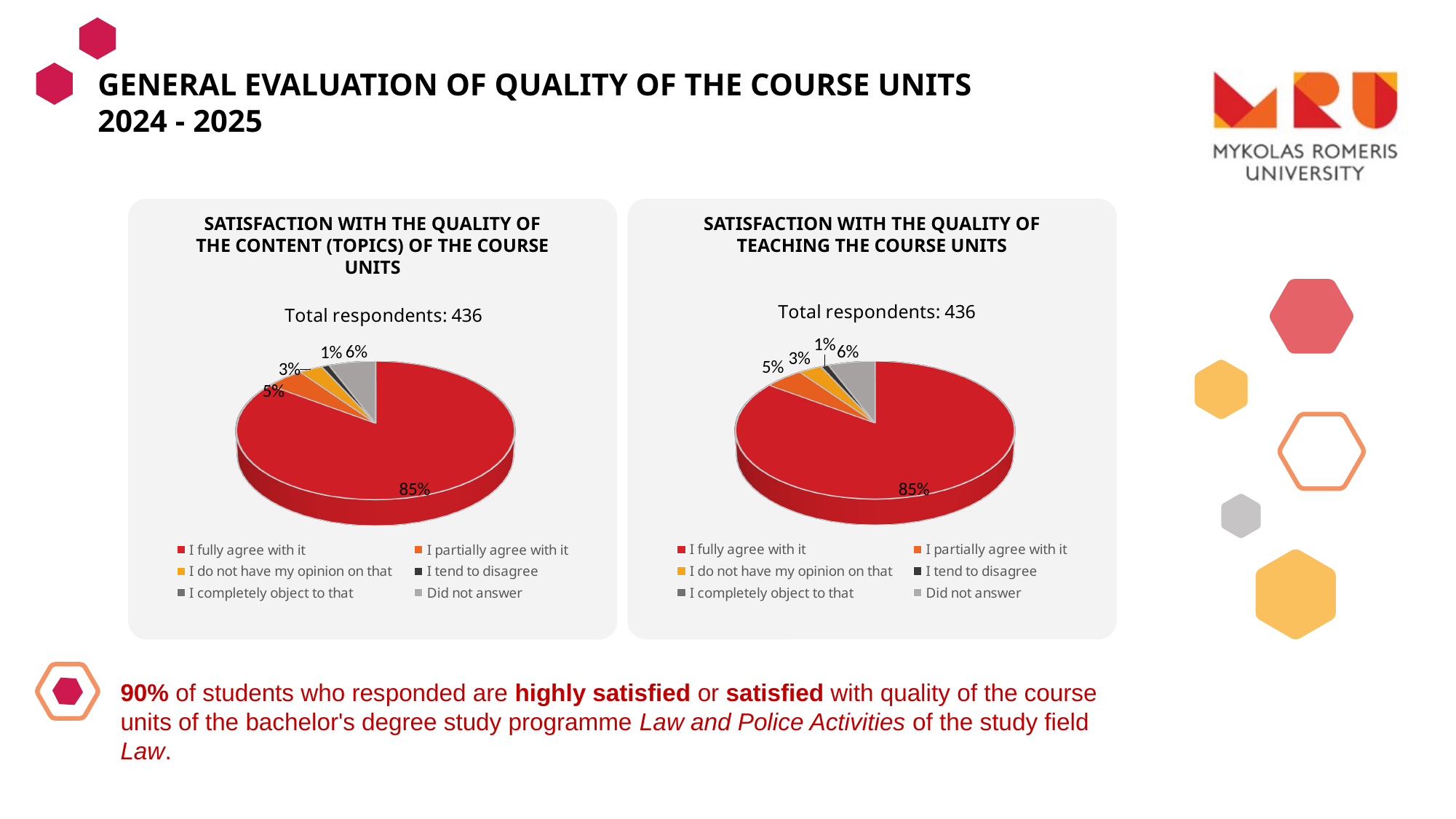
In the 'Satisfaction with the quality of teaching the course units' chart, what share of respondents chose 'I tend to disagree'? 1% In the 'Satisfaction with the quality of teaching the course units' chart, which labelled response has the smallest share? I tend to disagree In the 'Satisfaction with the quality of the content (topics) of the course units' chart, what share of respondents chose 'I fully agree with it'? 85% In the 'Satisfaction with the quality of teaching the course units' chart, what share of respondents 'Did not answer'? 6% In the 'Satisfaction with the quality of the content (topics) of the course units' chart, which response has the largest share? I fully agree with it What type of chart is used in the 'Satisfaction with the quality of the content (topics) of the course units' chart? Pie chart In the 'Satisfaction with the quality of the content (topics) of the course units' chart, what share of respondents chose 'I do not have my opinion on that'? 3% In the 'Satisfaction with the quality of teaching the course units' chart, which is larger: the 'Did not answer' share or the 'I partially agree with it' share? Did not answer In the 'Satisfaction with the quality of the content (topics) of the course units' chart, what is the difference between the 'I fully agree with it' share and the 'I partially agree with it' share? 80% In the 'Satisfaction with the quality of teaching the course units' chart, what share of respondents chose 'I partially agree with it'? 5% How many total respondents are reported for the 'Satisfaction with the quality of the content (topics) of the course units' chart? 436 How many entries does the legend of the 'Satisfaction with the quality of teaching the course units' chart list? 6